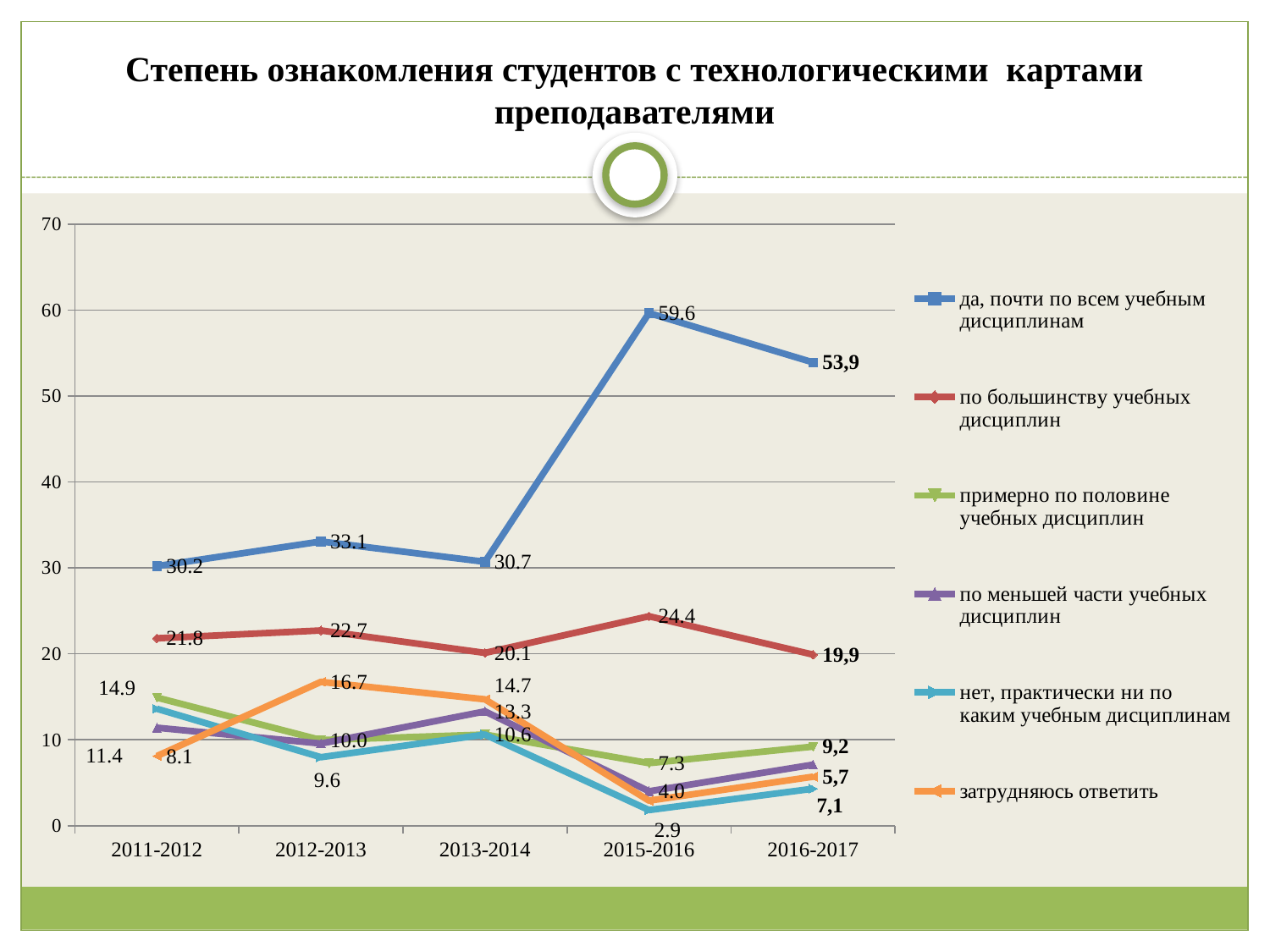
In which year is the value for "да, почти по всем учебным дисциплинам" highest? 2015-2016 Does the value for "да, почти по всем учебным дисциплинам" rise or fall from 2013-2014 to 2015-2016? rise In which year is the value for "по большинству учебных дисциплин" lowest? 2016-2017 What is the value for "по большинству учебных дисциплин" in 2013-2014? 20.1 What is the difference between the 2012-2013 and 2011-2012 values for "да, почти по всем учебным дисциплинам"? 2.9 What kind of chart is shown on the slide? line chart What is the value for "затрудняюсь ответить" in 2012-2013? 16.7 How many series does the legend list? 6 What is the value for "да, почти по всем учебным дисциплинам" in 2016-2017? 53,9 Is the value for "да, почти по всем учебным дисциплинам" in 2015-2016 greater or less than 50? greater What is the value for "да, почти по всем учебным дисциплинам" in 2015-2016? 59.6 How many academic-year categories are shown on the x axis? 5